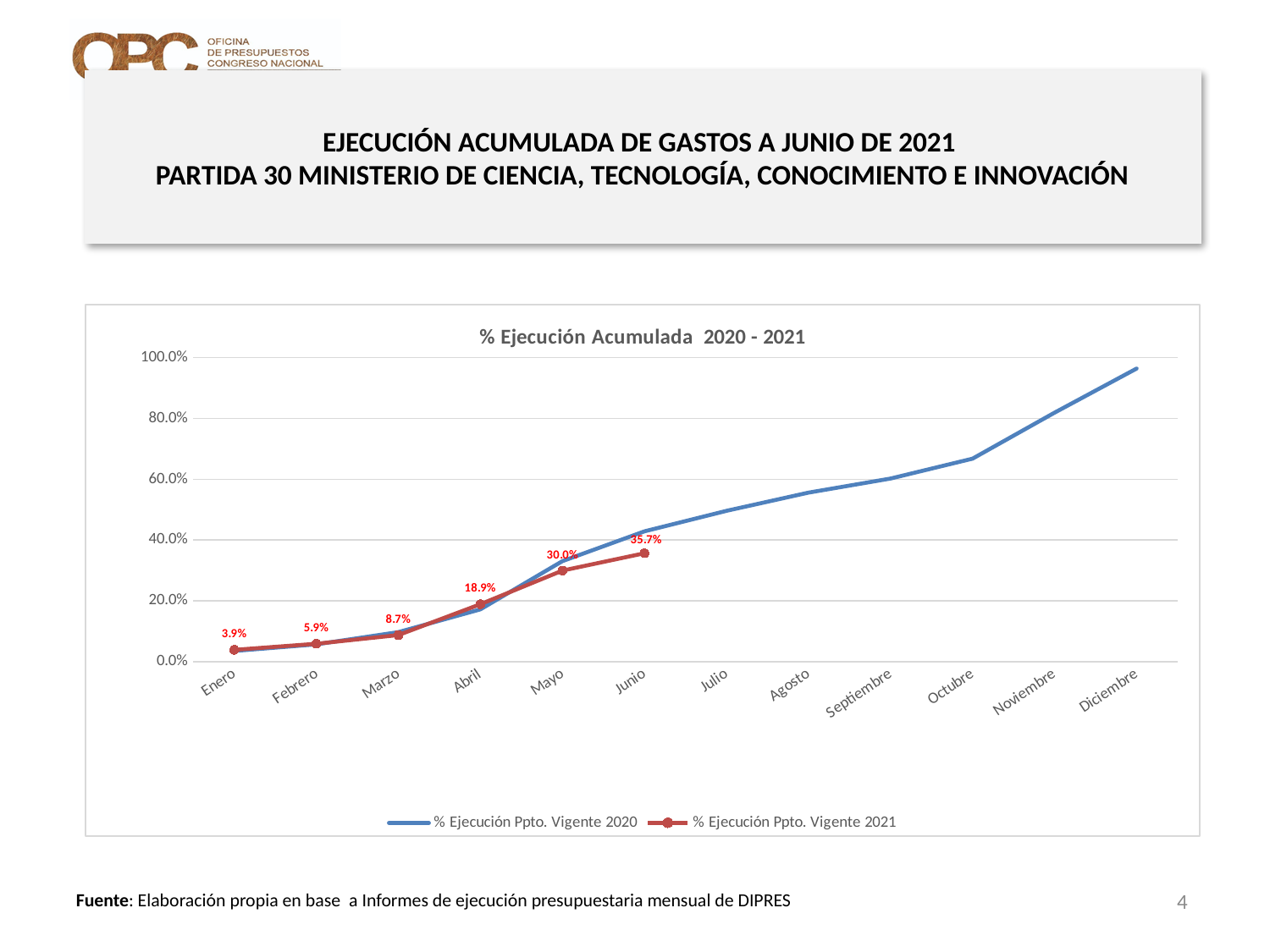
What kind of chart is shown on the slide? line chart What is the value for Enero in the % Ejecución Ppto. Vigente 2021 series? 3.9% What is the difference between the Junio and Mayo values in the % Ejecución Ppto. Vigente 2021 series? 5.7% Which month has the highest labelled value in the % Ejecución Ppto. Vigente 2021 series? Junio How many months are shown on the x axis of the chart? 12 What is the value for Junio in the % Ejecución Ppto. Vigente 2021 series? 35.7% Which month has the lowest labelled value in the % Ejecución Ppto. Vigente 2021 series? Enero Is the value for Julio in the % Ejecución Ppto. Vigente 2020 series greater or less than 40.0%? greater How many series does the chart legend list? 2 What is the difference between the Abril and Marzo values in the % Ejecución Ppto. Vigente 2021 series? 10.2% Is the value for Diciembre in the % Ejecución Ppto. Vigente 2020 series greater or less than 80.0%? greater What is the value for Marzo in the % Ejecución Ppto. Vigente 2021 series? 8.7%